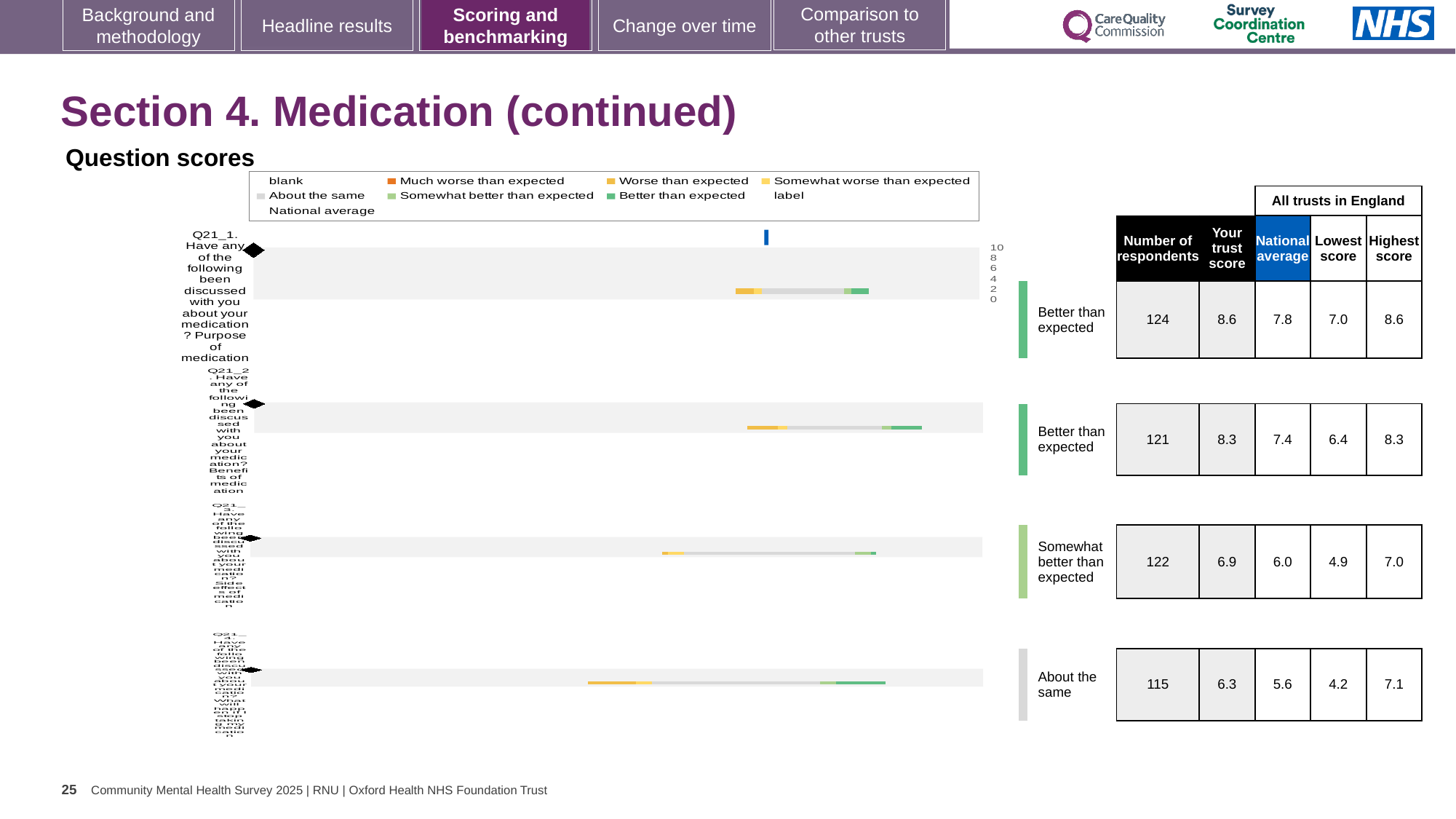
In the table, what is the national average for the third row (Q21_3)? 6.0 What kind of chart is shown under "Question scores"? bar chart Which question has the highest number of respondents in the table? Q21_1 In the table, what is the highest score for the fourth row (Q21_4)? 7.1 In the table, what is your trust score for Q21_2 (Benefits of medication)? 8.3 How many question bars (Q21_1 to Q21_4) are plotted in the chart? 4 How many entries does the chart legend list? 9 What is the difference between your trust score and the national average for Q21_1? 0.8 Which question has the lowest number of respondents in the table? Q21_4 For Q21_2, which is larger: your trust score or the national average? Your trust score In the table, what is the number of respondents for Q21_1 (Purpose of medication)? 124 What benchmark category label is shown next to the fourth row (Q21_4)? About the same